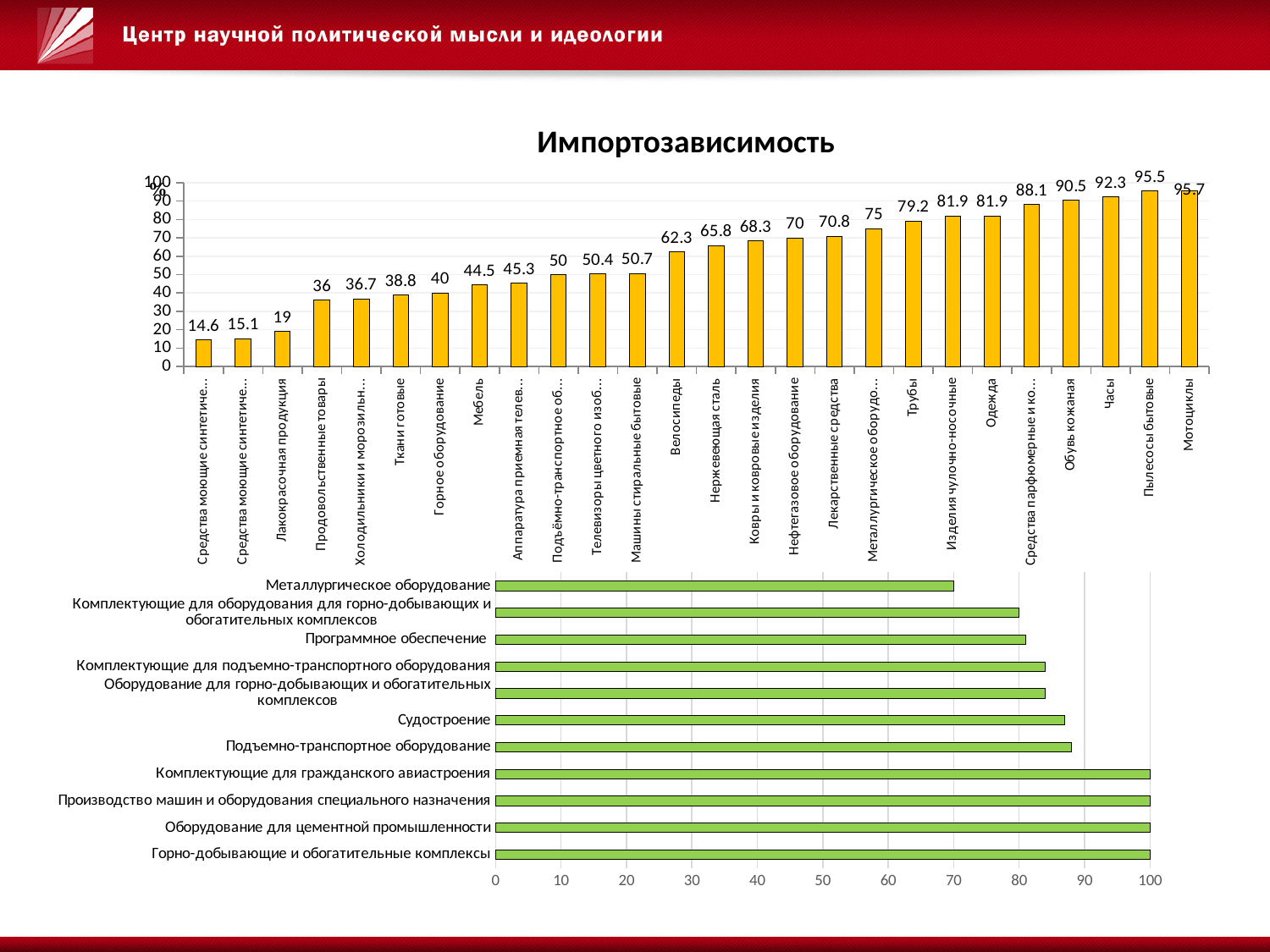
In the top chart titled Импортозависимость, which category has the highest value? Мотоциклы In the top chart titled Импортозависимость, do the values rise or fall from left to right along the x axis? rise In the bottom chart, which category has the lowest value? Металлургическое оборудование In the top chart titled Импортозависимость, what is the difference between the values for Часы and Обувь кожаная? 1.8 What kind of chart is the bottom chart on the slide? bar chart In the top chart titled Импортозависимость, which is larger: the value for Велосипеды or the value for Мебель? Велосипеды In the bottom chart, is the value for Металлургическое оборудование greater or less than 80? less In the bottom chart, how many categories are plotted? 11 In the top chart titled Импортозависимость, how many categories are plotted? 26 In the top chart titled Импортозависимость, what is the value for Лакокрасочная продукция? 19 In the top chart titled Импортозависимость, what is the value for Лекарственные средства? 70.8 In the top chart titled Импортозависимость, what is the value for Мотоциклы? 95.7